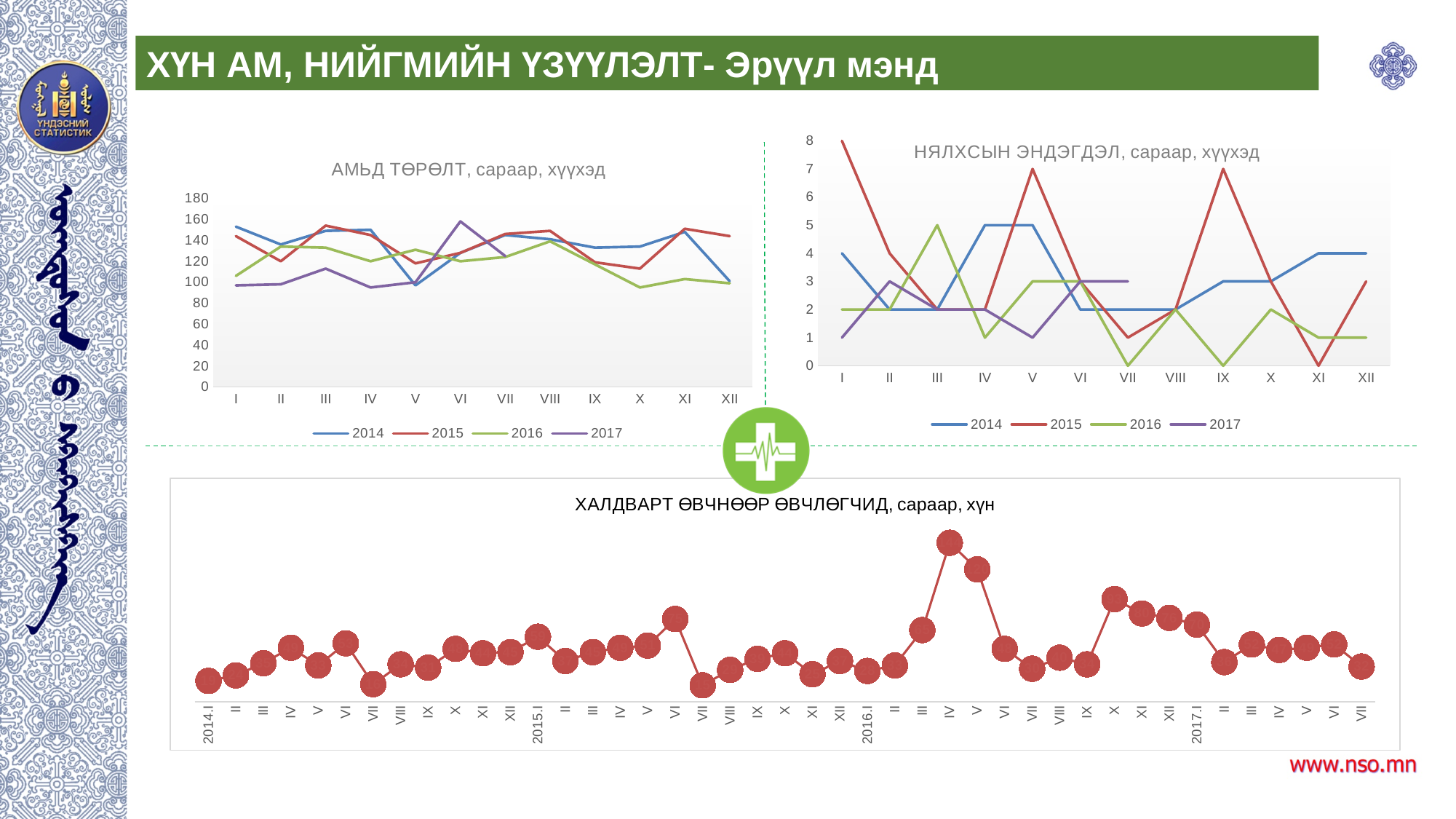
In the 'АМЬД ТӨРӨЛТ, сараар, хүүхэд' chart, is the value for 2017 in month VI greater or less than 140? greater In the 'НЯЛХСЫН ЭНДЭГДЭЛ, сараар, хүүхэд' chart, which is larger in month V: the 2015 value or the 2014 value? 2015 In the 'ХАЛДВАРТ ӨВЧНӨӨР ӨВЧЛӨГЧИД, сараар, хүн' chart, which month has the highest value? 2016.IV In the 'АМЬД ТӨРӨЛТ, сараар, хүүхэд' chart, is the value for 2014 in month V greater or less than 120? less In the 'НЯЛХСЫН ЭНДЭГДЭЛ, сараар, хүүхэд' chart, what is the difference between the 2015 and 2014 values in month I? 4 In the 'НЯЛХСЫН ЭНДЭГДЭЛ, сараар, хүүхэд' chart, what is the value for 2016 in month VII? 0 How many series does the legend of the 'АМЬД ТӨРӨЛТ, сараар, хүүхэд' chart list? 4 In the 'НЯЛХСЫН ЭНДЭГДЭЛ, сараар, хүүхэд' chart, what is the value for 2016 in month III? 5 What kind of chart is the 'АМЬД ТӨРӨЛТ, сараар, хүүхэд' chart? line chart How many months are shown on the x axis of the 'НЯЛХСЫН ЭНДЭГДЭЛ, сараар, хүүхэд' chart? 12 In the 'НЯЛХСЫН ЭНДЭГДЭЛ, сараар, хүүхэд' chart, which series has the highest value in month IX? 2015 In the 'НЯЛХСЫН ЭНДЭГДЭЛ, сараар, хүүхэд' chart, what is the value for 2015 in month I? 8